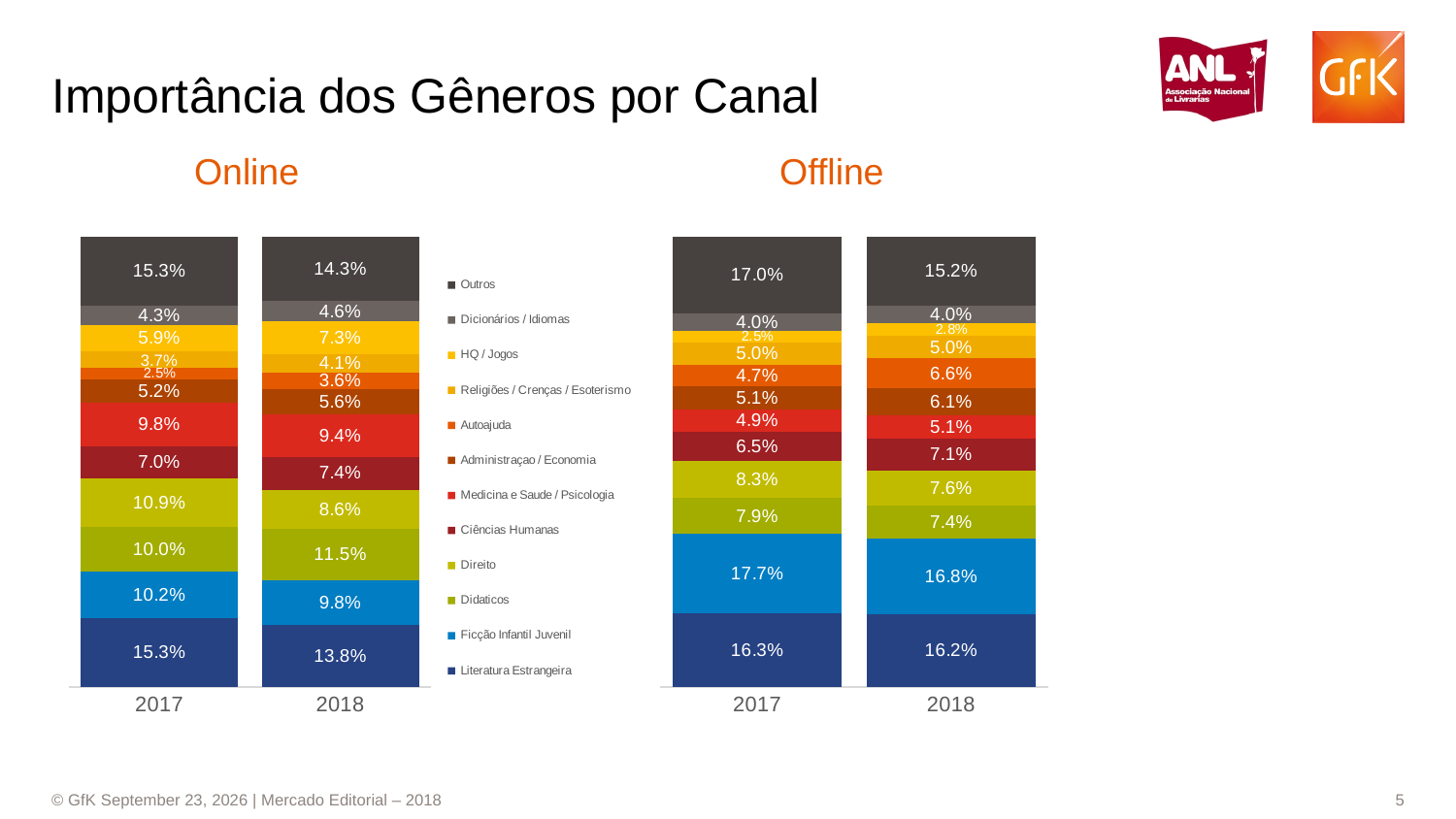
In the Online chart, what is the difference between the Outros values for 2017 and 2018? 1.0% How many series does the legend list? 12 In the Offline chart, what is the value for Ficção Infantil Juvenil in 2017? 17.7% In the Offline chart, what is the value for Ciências Humanas in 2018? 7.1% How many years are shown on the x axis of the Offline chart? 2 In the Offline chart, what is the difference between the Ficção Infantil Juvenil values for 2017 and 2018? 0.9% In the Online chart, what is the value for Didaticos in 2018? 11.5% In the Offline chart, what is the value for Outros in 2018? 15.2% In the Online chart, what is the value for Medicina e Saude / Psicologia in 2018? 9.4% What kind of chart is the Online chart? Stacked bar chart In the Online chart, what is the value for Literatura Estrangeira in 2017? 15.3% In the Online chart, which is larger in 2018: Direito or Didaticos? Didaticos